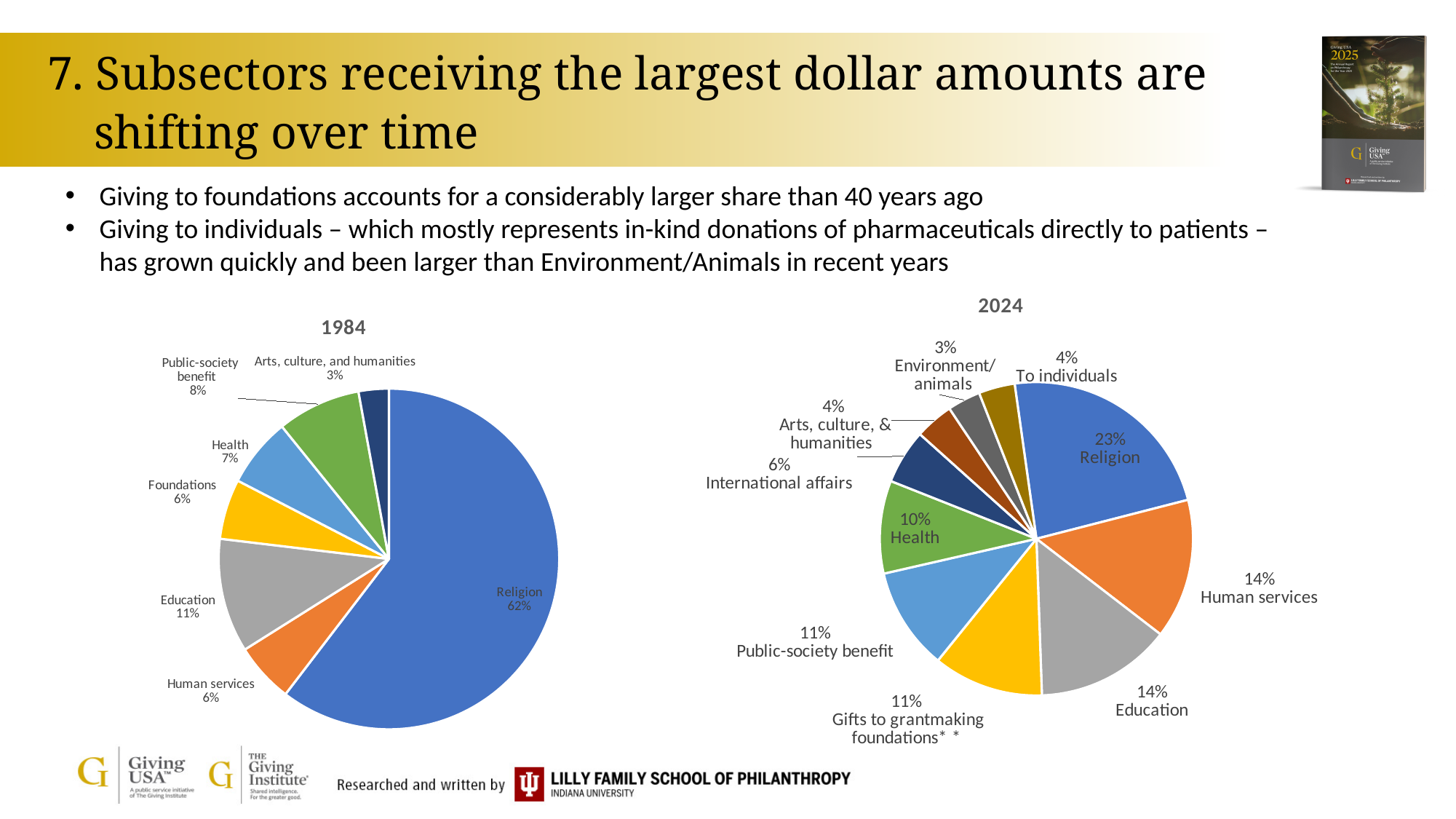
In the 1984 pie chart, what is the difference between the Education share and the Health share? 4 percentage points In the 2024 pie chart, what share goes to Gifts to grantmaking foundations? 11% In the 2024 pie chart, which is larger: the share for Health or the share for International affairs? Health In the 1984 pie chart, which category has the largest share? Religion How many slices does the 2024 pie chart have? 10 In the 1984 pie chart, what share does Religion account for? 62% How many slices does the 1984 pie chart have? 7 In the 2024 pie chart, what share does Health account for? 10% In the 2024 pie chart, which category has the smallest share? Environment/animals What is the difference between the Religion share in the 1984 chart and the Religion share in the 2024 chart? 39 percentage points In the 1984 pie chart, which category has the smallest share? Arts, culture, and humanities What type of chart is used to show the 1984 data? Pie chart